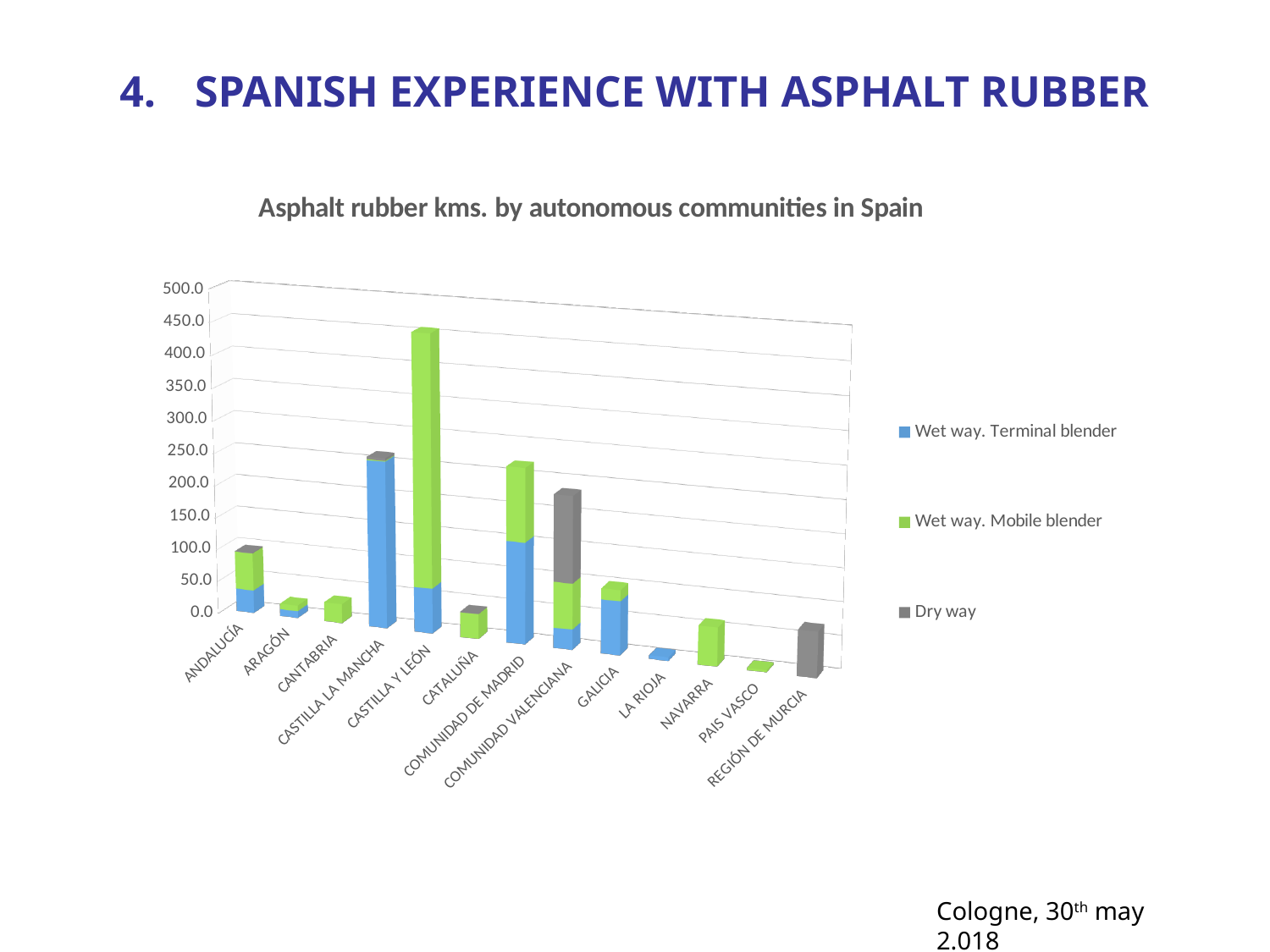
What kind of chart is shown on the slide? Stacked bar chart Is the total value for Castilla La Mancha greater or less than 150.0? greater How many autonomous communities are shown on the x axis? 13 Is the total value for Castilla y León greater or less than 350.0? greater Is the total value for Aragón greater or less than 50.0? less Which has a larger total, Castilla y León or Comunidad de Madrid? Castilla y León Which has a larger total, Castilla La Mancha or Galicia? Castilla La Mancha What is the title of the chart? Asphalt rubber kms. by autonomous communities in Spain Which autonomous community has the highest total asphalt rubber kms? Castilla y León Which series is shown in grey in the legend? Dry way How many series does the legend list? 3